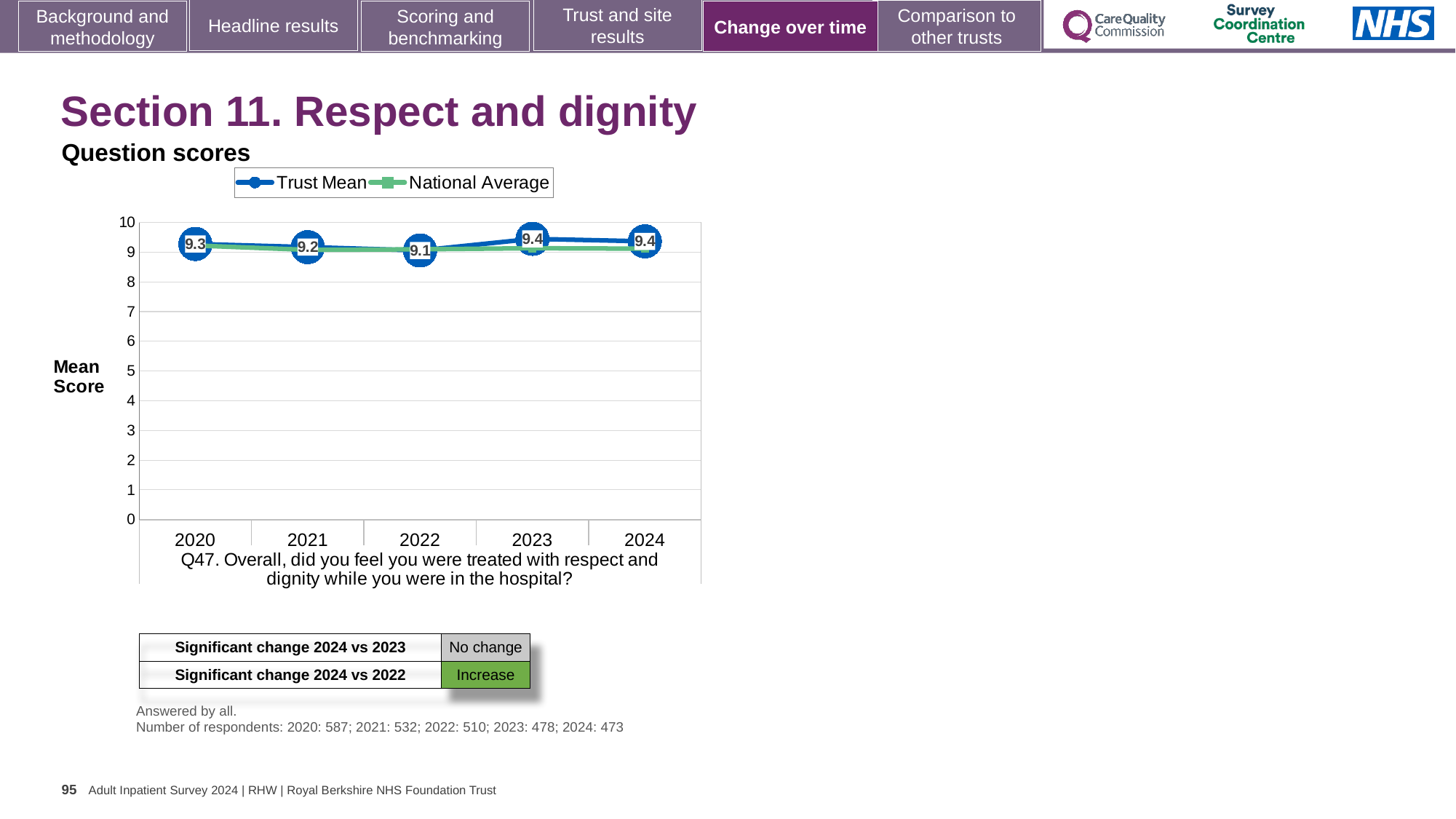
Which year has the higher Trust Mean score, 2020 or 2021? 2020 What are the two series named in the legend? Trust Mean and National Average What kind of chart is shown on the slide? line chart How many years are plotted on the x axis? 5 What is the difference between the Trust Mean scores for 2023 and 2022? 0.3 Is the National Average value for 2020 greater or less than 8? greater In which year is the Trust Mean score lowest? 2022 Does the Trust Mean score rise or fall from 2020 to 2022? fall What is the Trust Mean score for 2020? 9.3 What is the Trust Mean score for 2024? 9.4 What is the Trust Mean score for 2022? 9.1 How many series does the legend list? 2